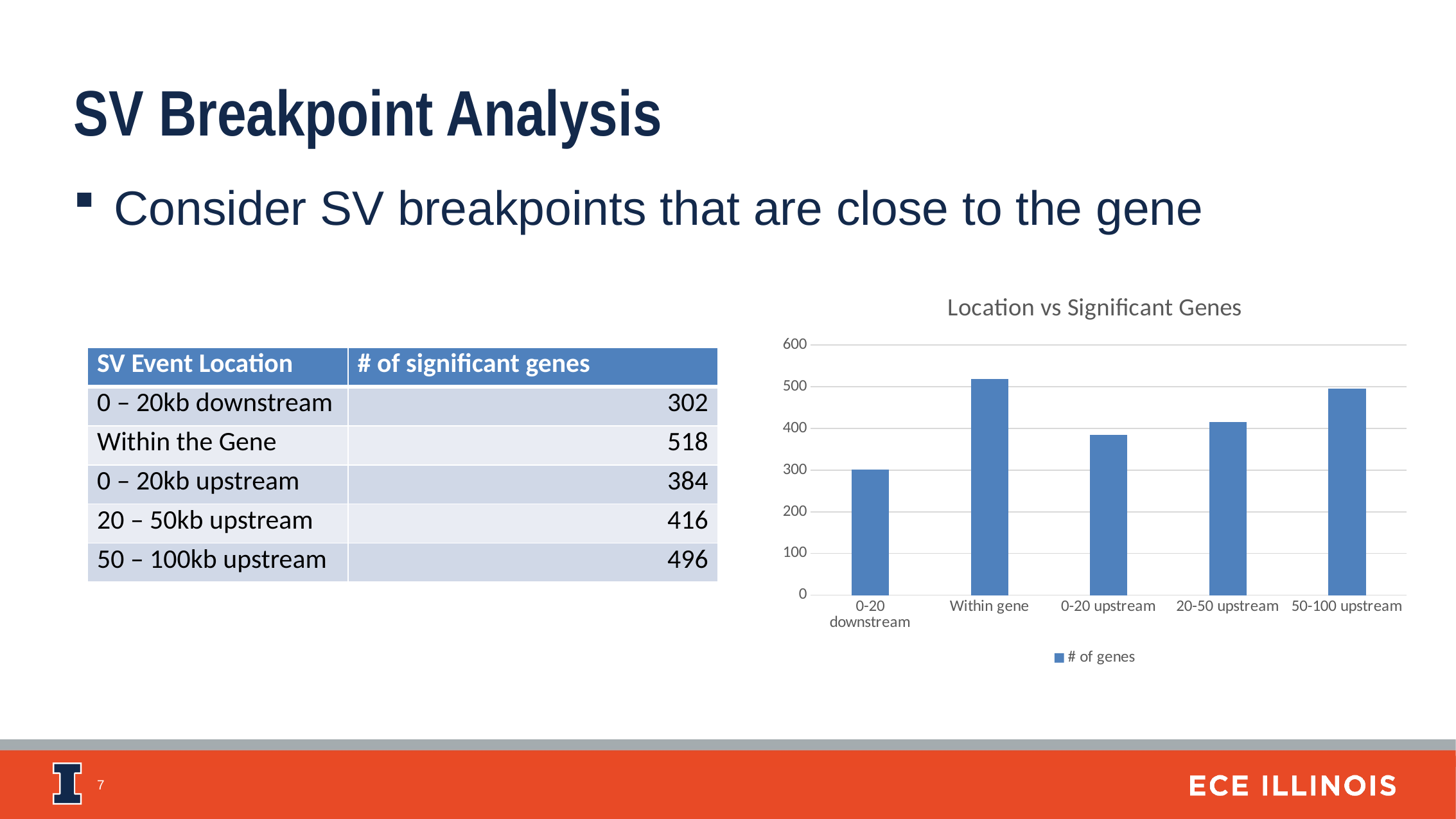
What kind of chart is shown on the slide? bar chart Is the value for Within gene greater or less than 500? greater Is the value for 0-20 upstream greater or less than 400? less Which category has the lowest bar in the chart? 0-20 downstream What is the number of significant genes for 0-20 downstream, as given on the slide? 302 How many series does the chart legend list? 1 Which category has the highest bar in the chart? Within gene Which is larger, the value for 20-50 upstream or the value for 0-20 upstream? 20-50 upstream Is the value for 50-100 upstream greater or less than 400? greater What is the title of the chart? Location vs Significant Genes How many categories are plotted on the x axis of the chart? 5 What is the difference between the number of significant genes for Within gene and for 0-20 downstream, using the values given on the slide? 216